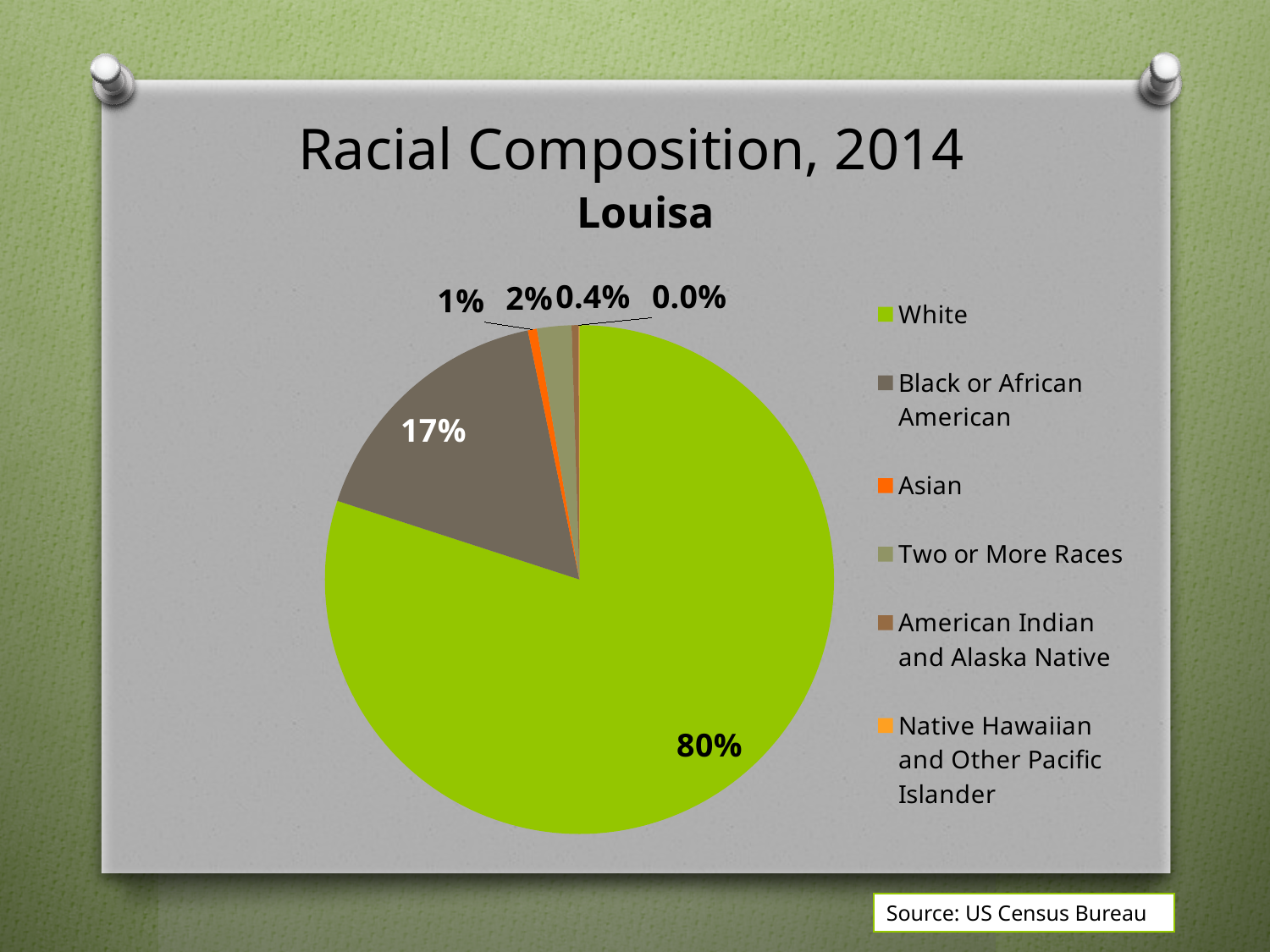
What percentage of the pie chart is American Indian and Alaska Native? 0.4% What is the difference in percentage points between the White and Black or African American shares? 63 What percentage of the pie chart is Black or African American? 17% What is the title of the chart? Racial Composition, 2014 Which racial group has the largest share of the pie chart? White Which racial group has the smallest share of the pie chart? Native Hawaiian and Other Pacific Islander Which is larger, the Asian share or the Two or More Races share? Two or More Races What percentage of the pie chart is Native Hawaiian and Other Pacific Islander? 0.0% What percentage of the pie chart is White? 80% How many racial groups are listed in the legend of the pie chart? 6 What type of chart is shown on the slide? pie chart What percentage of the pie chart is Two or More Races? 2%